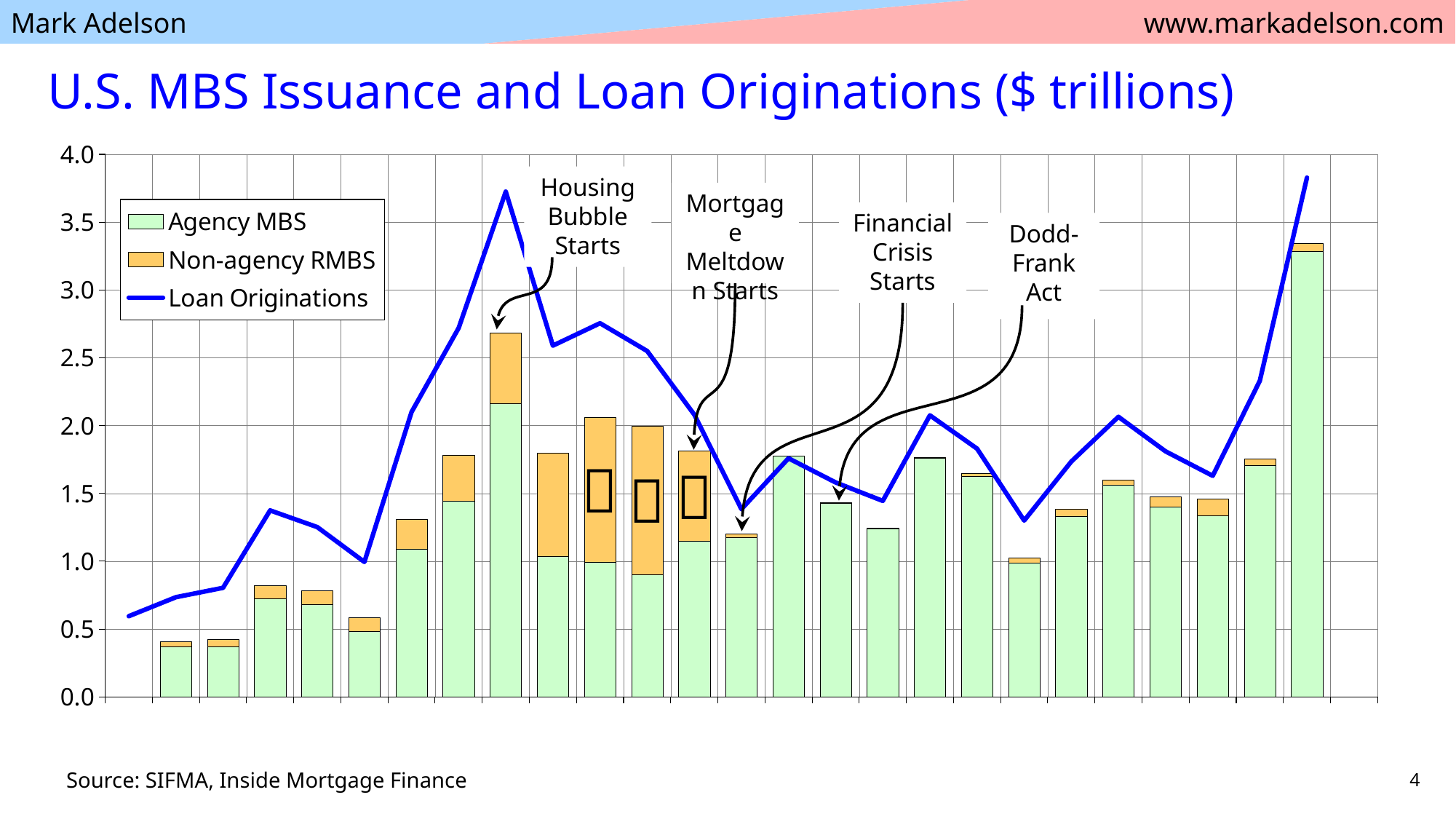
Which of the two stacked series is larger in the rightmost bar, Agency MBS or Non-agency RMBS? Agency MBS Does the Loan Originations line end higher or lower than it starts? higher Which series is drawn as a line rather than as bars? Loan Originations What are the three series named in the legend? Agency MBS, Non-agency RMBS, Loan Originations Is the total of the rightmost bar greater or less than 3.0? greater How many series does the legend list? 3 Which bar has the highest total MBS issuance? The rightmost (last) bar What is the maximum value shown on the vertical axis? 4.0 Is the total of the leftmost bar greater or less than 0.5? less Is the final value of the Loan Originations line greater or less than 3.5? greater What kind of chart is shown on the slide? A stacked bar chart with a line